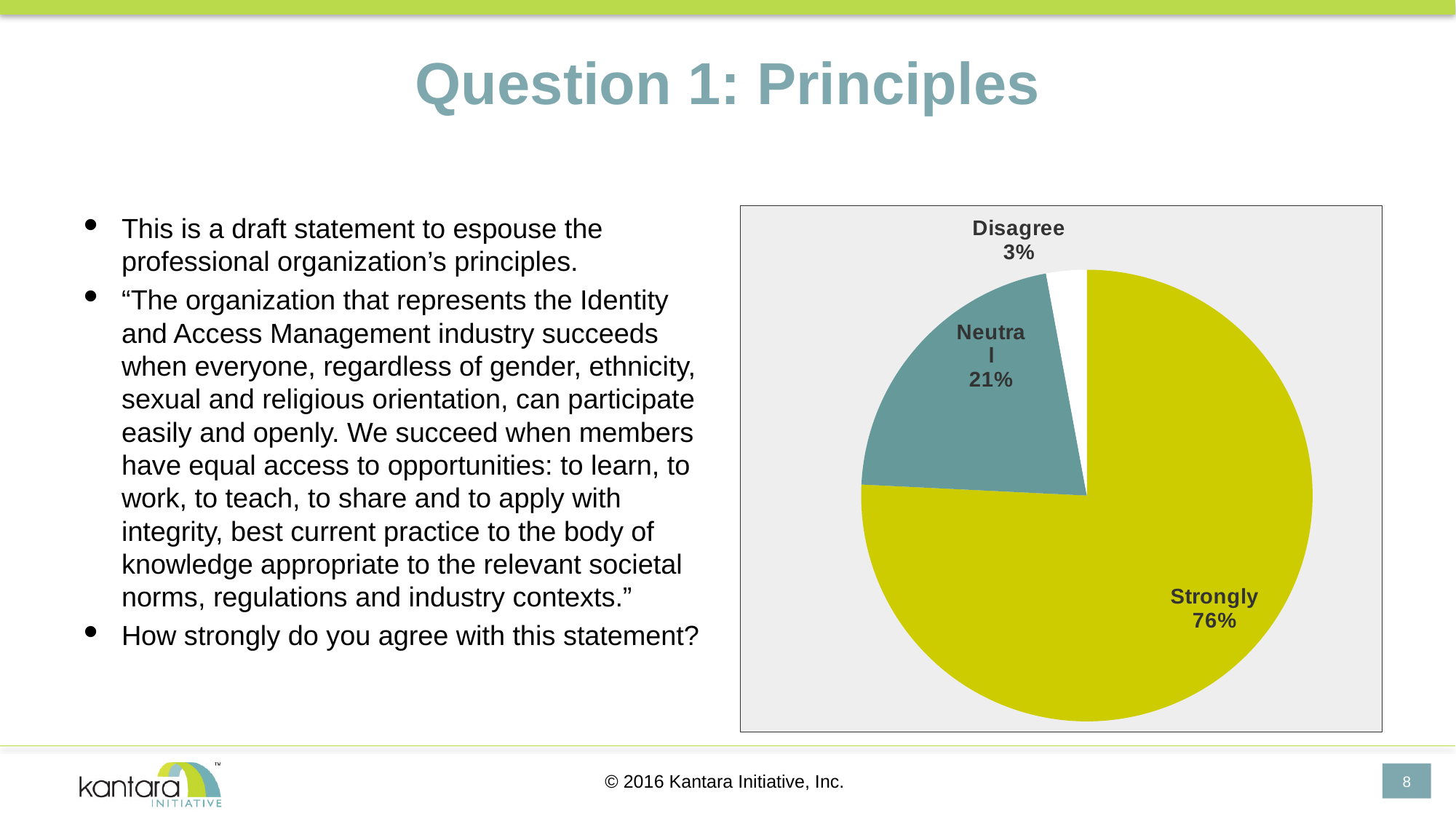
Which slice of the pie is the smallest? Disagree What colour is the Neutral slice of the pie? Teal What share of the pie does the Disagree slice represent? 3% What is the difference in percentage points between the Neutral and Disagree slices? 18 What share of the pie does the Neutral slice represent? 21% What is the difference in percentage points between the Strongly and Neutral slices? 55 What share of the pie does the Strongly slice represent? 76% What kind of chart is shown on the slide? Pie chart Which slice of the pie is the largest? Strongly What colour is the Strongly slice of the pie? Yellow-green How many slices does the pie chart have? 3 Which is larger, the Neutral slice or the Disagree slice? Neutral